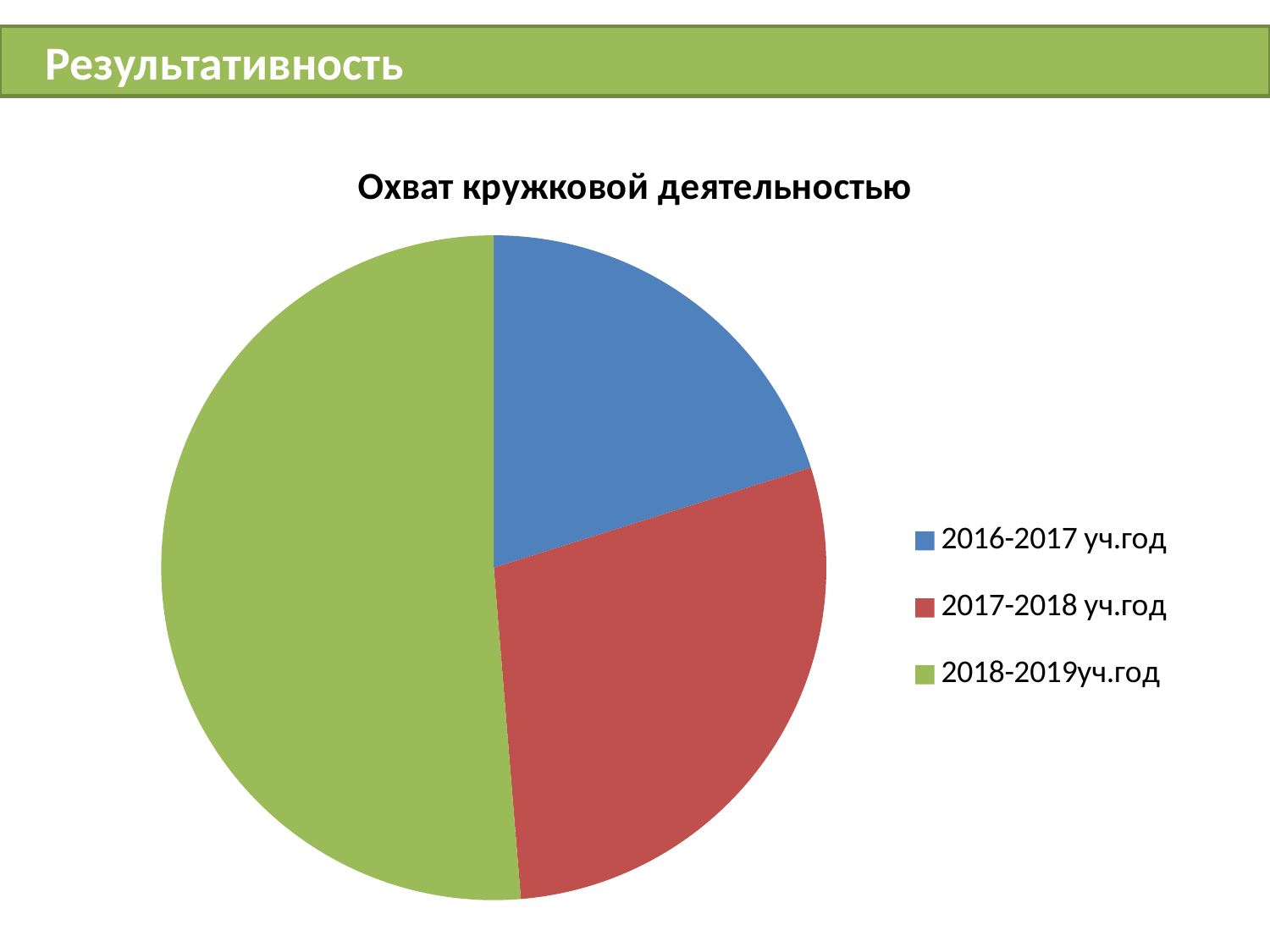
Which category has the smallest slice of the pie? 2016-2017 уч.год Which slice is larger: 2016-2017 уч.год or 2018-2019уч.год? 2018-2019уч.год Which category has the largest slice of the pie? 2018-2019уч.год Which slice is larger: 2016-2017 уч.год or 2017-2018 уч.год? 2017-2018 уч.год What colour is the slice for 2017-2018 уч.год? red How many entries does the legend list? 3 Does the share of the pie increase or decrease from 2016-2017 уч.год to 2018-2019уч.год? increase What kind of chart is shown on the slide? pie chart What is the title of the chart? Охват кружковой деятельностью How many slices does the pie chart have? 3 Which slice is larger: 2017-2018 уч.год or 2018-2019уч.год? 2018-2019уч.год